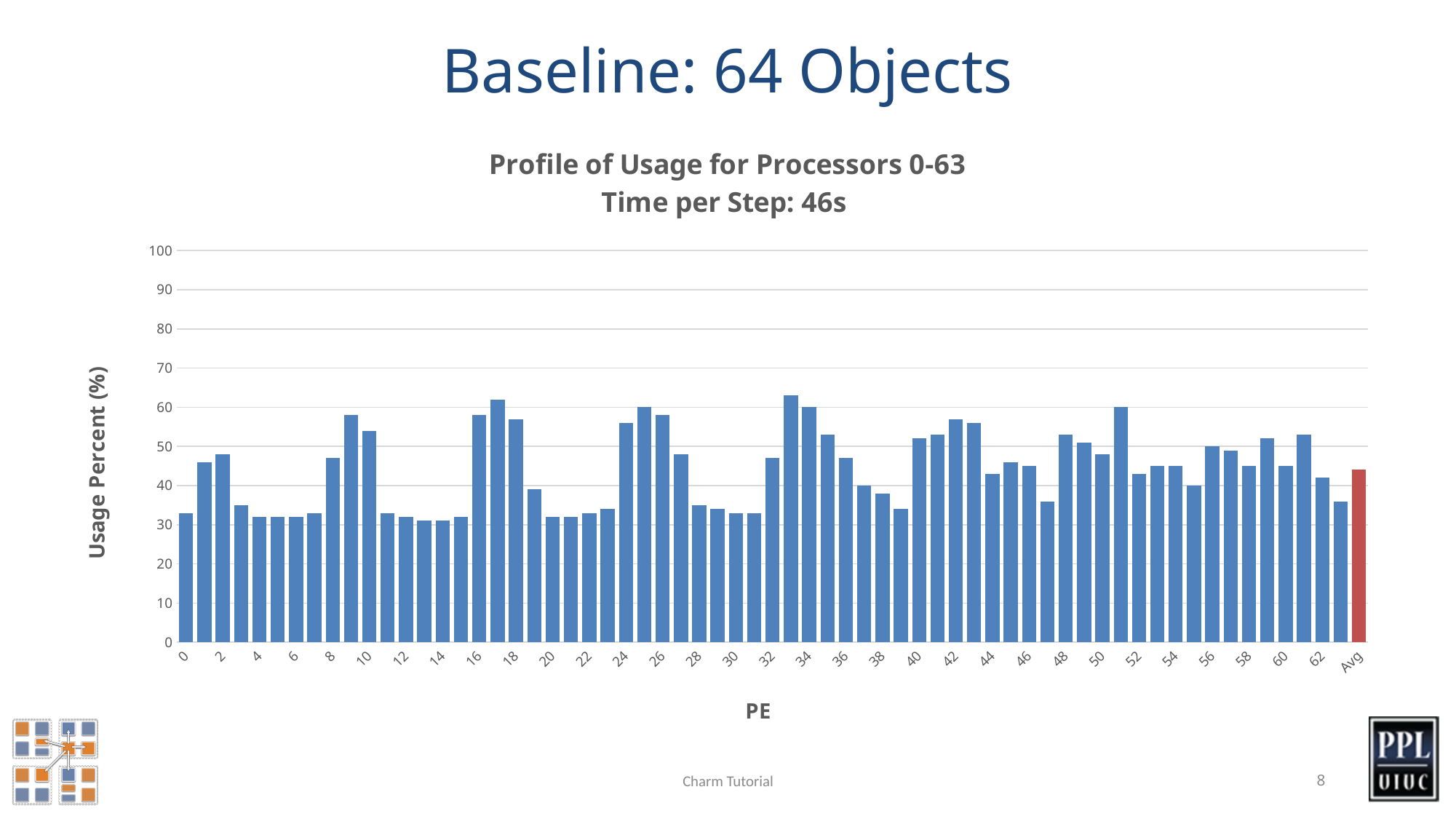
How many bars are plotted in the chart, including the Avg bar? 65 Is the value for Avg greater or less than 40? greater Is the value for PE 0 greater or less than 40? less What kind of chart is shown on the slide? bar chart Is the value for Avg greater or less than 50? less Which has a higher usage percent, PE 33 or PE 37? PE 33 What is the label of the y axis? Usage Percent (%) What is the title of the chart? Profile of Usage for Processors 0-63 Time per Step: 46s Which has a higher usage percent, PE 9 or PE 0? PE 9